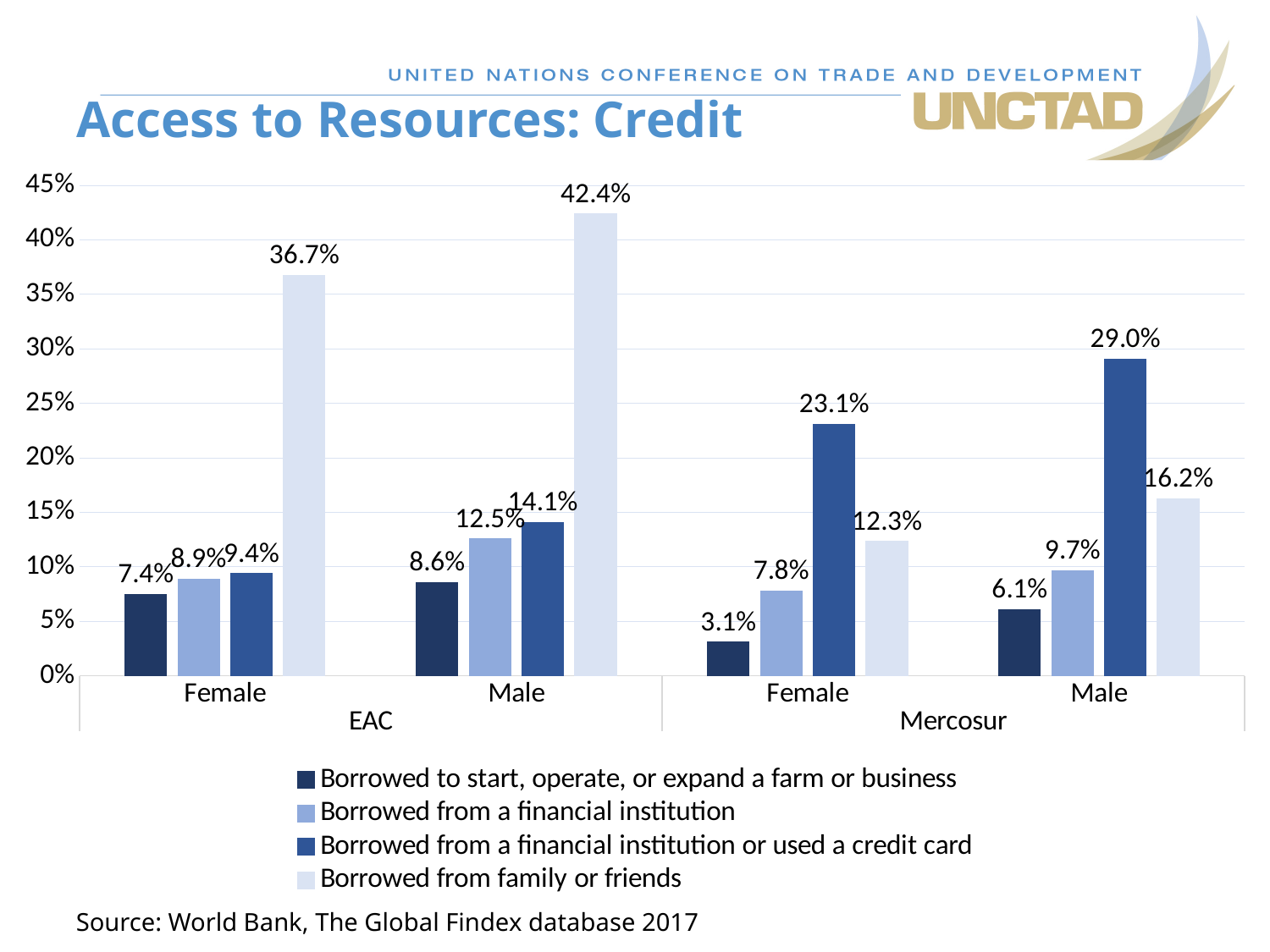
Which group has the lowest value for 'Borrowed to start, operate, or expand a farm or business'? Mercosur Female Which is larger: 'Borrowed from a financial institution or used a credit card' for Mercosur Female or for EAC Male? Mercosur Female What is the value for 'Borrowed to start, operate, or expand a farm or business' for Mercosur Female? 3.1% What kind of chart is shown on the slide? Bar chart How many series does the legend list? 4 What is the value for 'Borrowed from a financial institution or used a credit card' for Mercosur Male? 29.0% What is the value for 'Borrowed from family or friends' for EAC Male? 42.4% Which group has the highest value for 'Borrowed from family or friends'? EAC Male What is the source cited below the chart? World Bank, The Global Findex database 2017 What is the value for 'Borrowed from a financial institution' for EAC Female? 8.9% What is the difference between the 'Borrowed from family or friends' values for EAC Male and EAC Female? 5.7% Is the value for 'Borrowed from family or friends' for Mercosur Male greater or less than 20%? less